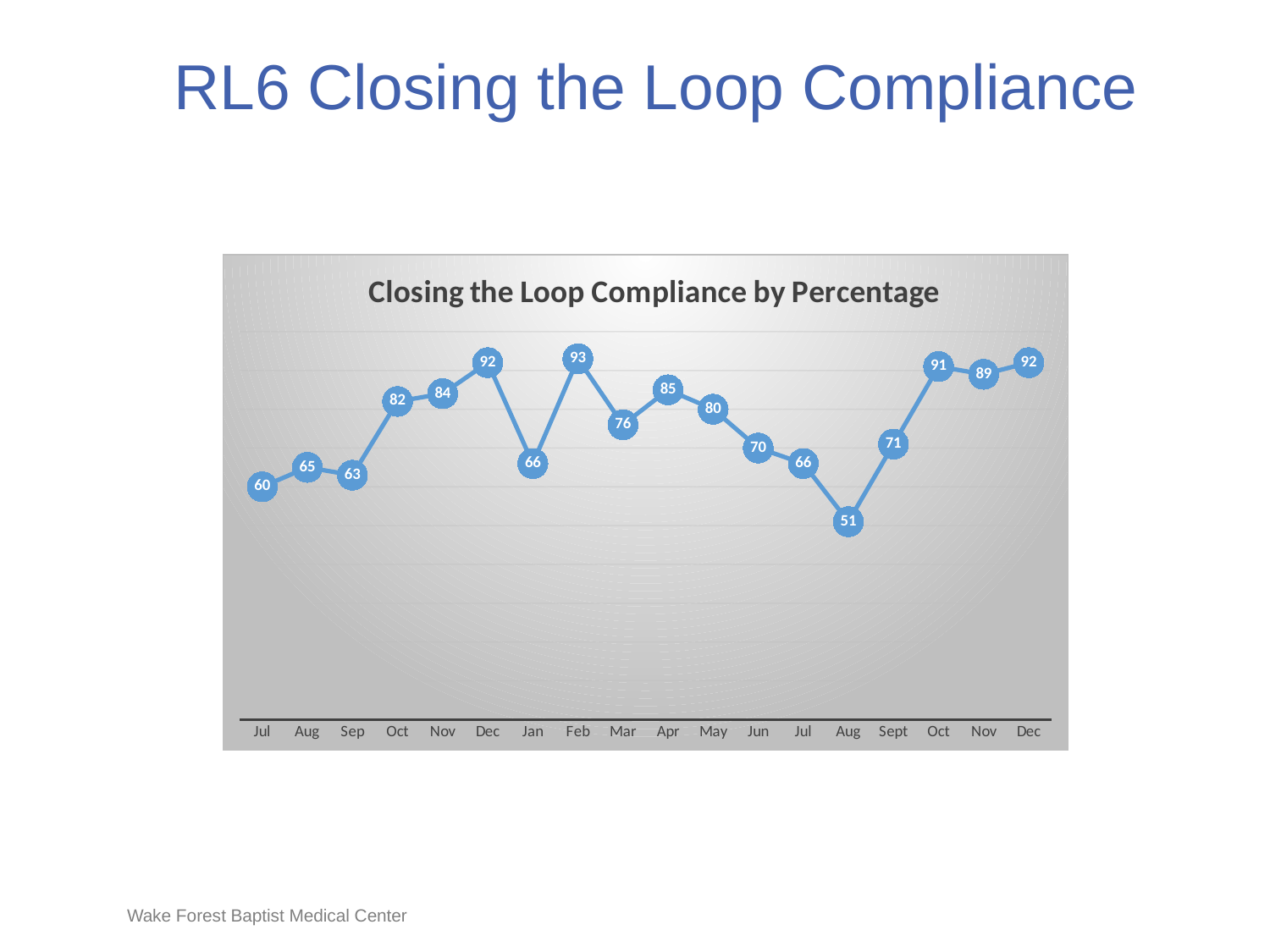
How many data points are plotted on the chart? 18 What is the difference between the values for Feb and Mar? 17 Do the values rise or fall from the second Aug to the second Oct? rise What is the compliance value for Sept? 71 What is the compliance value for Feb? 93 What is the compliance value for the first Jul on the x axis? 60 Which month has the highest compliance value? Feb Which month has the lowest compliance value? the second Aug Which is larger, the value for Apr or the value for May? Apr What is the difference between the values for the second Aug and Sept? 20 What type of chart is shown on the slide? line chart What is the title of the chart? Closing the Loop Compliance by Percentage